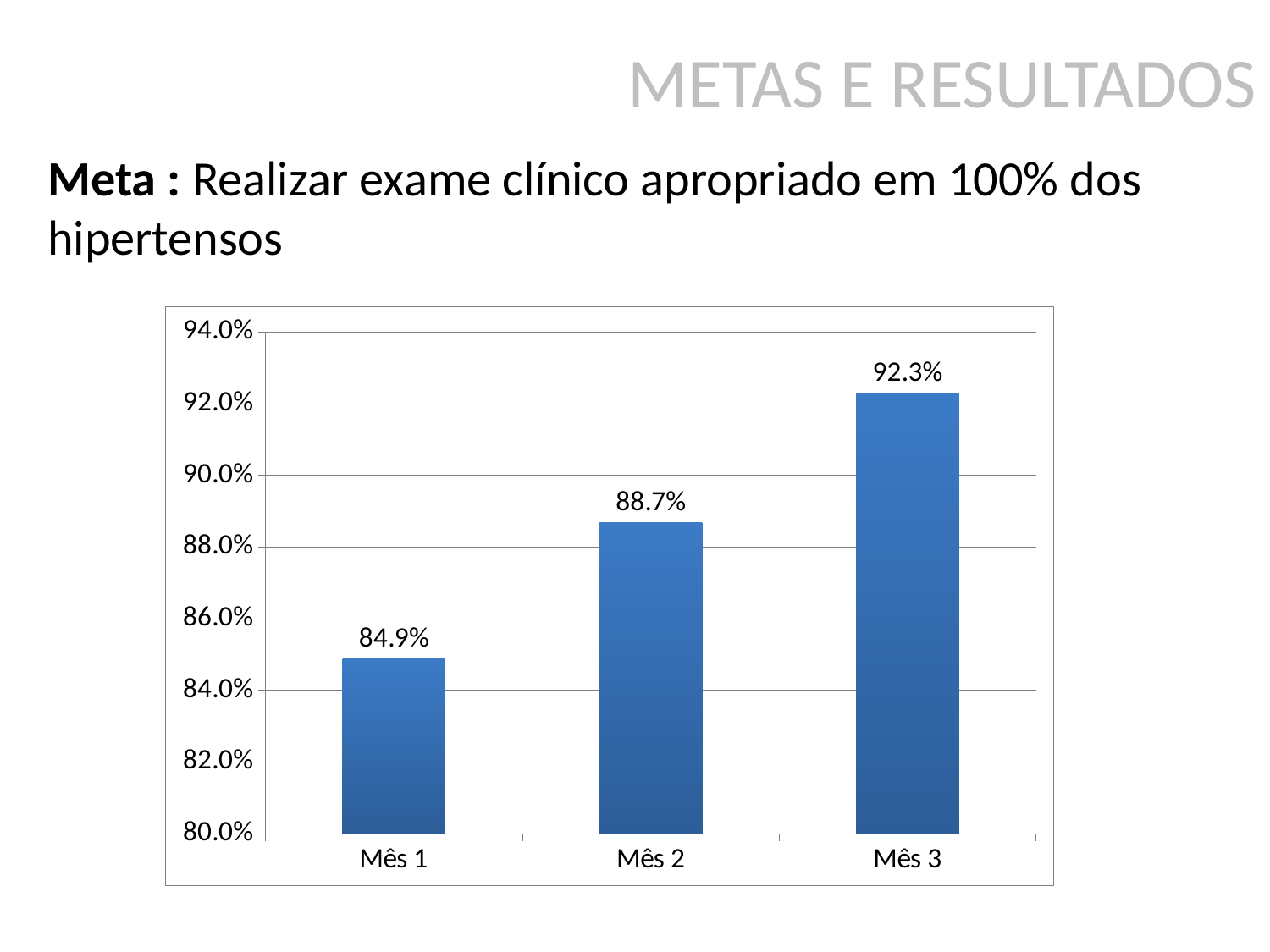
What is the difference between the values for Mês 2 and Mês 1? 3.8% What is the value for Mês 3? 92.3% What is the value for Mês 2? 88.7% What kind of chart is shown on the slide? bar chart Which month has the lowest value? Mês 1 Which is larger, the value for Mês 2 or the value for Mês 3? Mês 3 Is the value for Mês 2 greater or less than 90.0%? less What is the value for Mês 1? 84.9% Do the values rise or fall from Mês 1 to Mês 3? rise How many months are shown on the x axis? 3 What is the difference between the values for Mês 3 and Mês 1? 7.4% Which month has the highest value? Mês 3